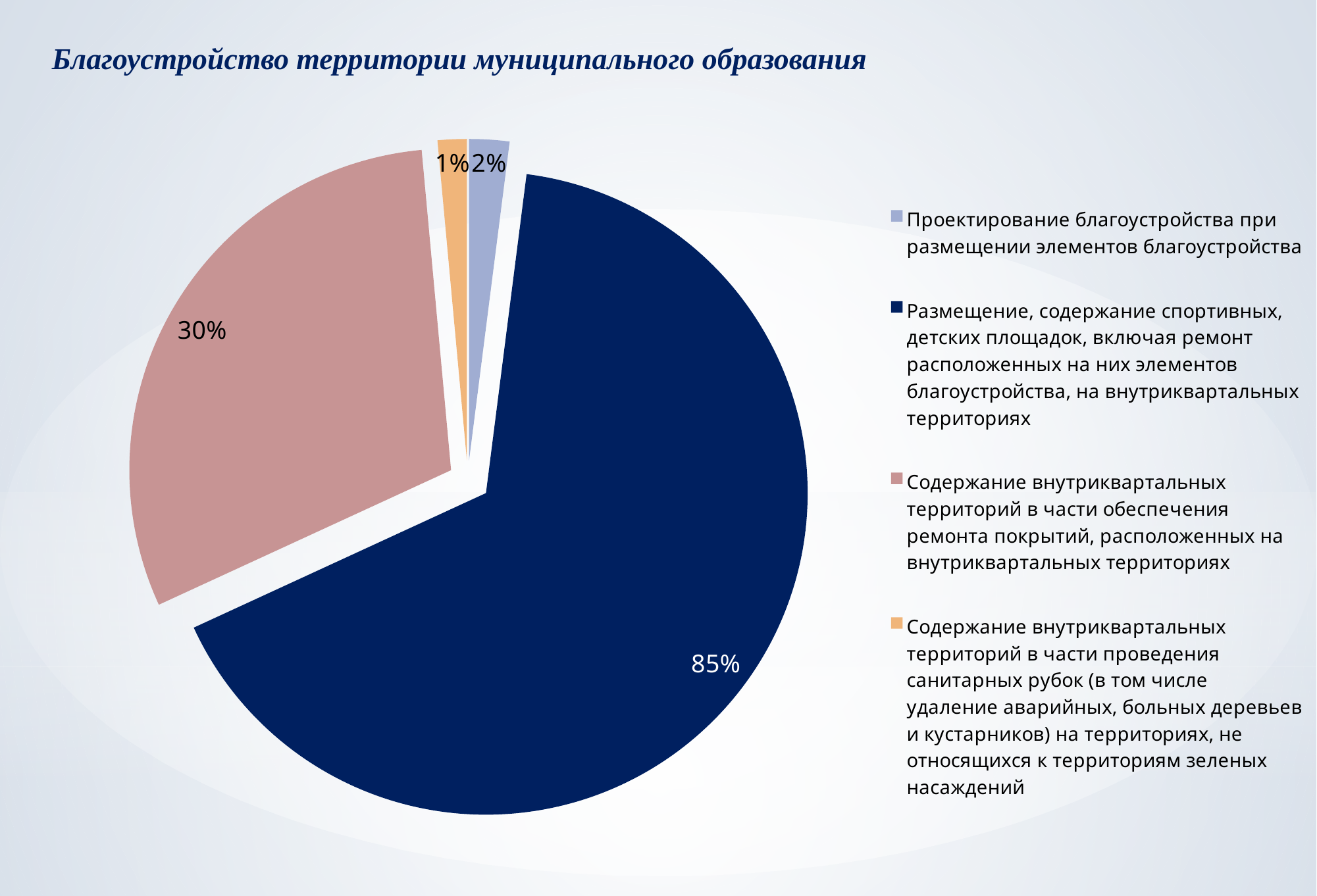
How many slices does the pie chart have? 4 What is the value shown for the slice "Содержание внутриквартальных территорий в части проведения санитарных рубок"? 1% What is the value shown for the slice "Содержание внутриквартальных территорий в части обеспечения ремонта покрытий, расположенных на внутриквартальных территориях"? 30% Which is larger: the slice for "Проектирование благоустройства при размещении элементов благоустройства" or the slice for "Содержание внутриквартальных территорий в части обеспечения ремонта покрытий"? Содержание внутриквартальных территорий в части обеспечения ремонта покрытий, расположенных на внутриквартальных территориях What is the difference between the largest slice (85%) and the slice labelled 30%? 55% How many entries does the legend list? 4 What is the title of the slide? Благоустройство территории муниципального образования What kind of chart is shown on the slide? pie chart What is the value shown for the slice "Размещение, содержание спортивных, детских площадок, включая ремонт расположенных на них элементов благоустройства, на внутриквартальных территориях"? 85% Which category has the largest slice of the pie? Размещение, содержание спортивных, детских площадок, включая ремонт расположенных на них элементов благоустройства, на внутриквартальных территориях What is the value shown for the slice "Проектирование благоустройства при размещении элементов благоустройства"? 2%